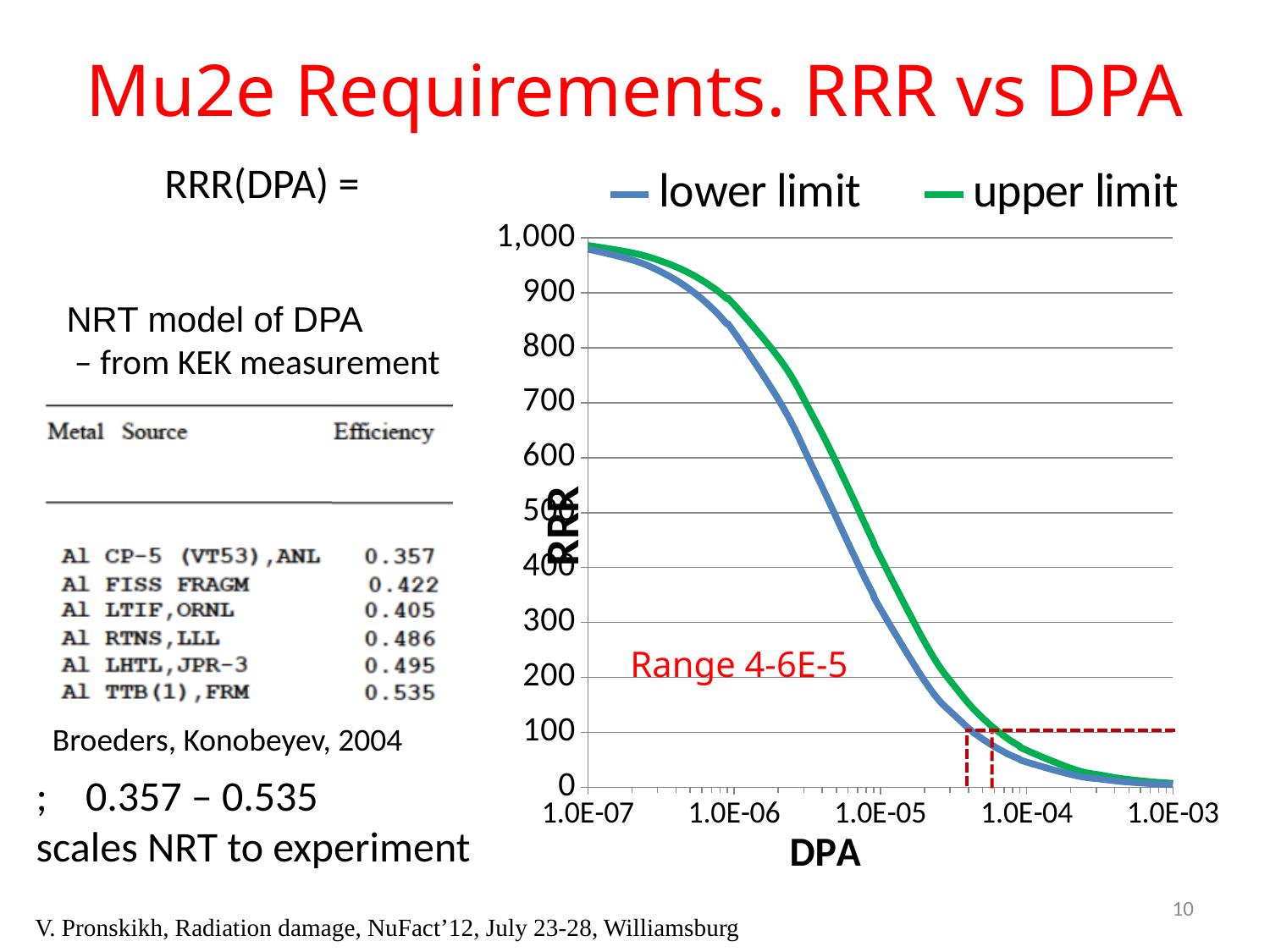
Is the upper limit value at DPA 1.0E-06 greater or less than 800? greater Is the upper limit value at DPA 1.0E-04 greater or less than 100? less What is the label of the x axis of the chart? DPA Is the lower limit value at DPA 1.0E-07 greater or less than 900? greater How many series does the chart legend list? 2 Do the RRR values rise or fall as DPA increases along the x axis? fall At DPA 1.0E-05, which series has the higher RRR value, lower limit or upper limit? upper limit What is the highest tick value shown on the y axis of the chart? 1,000 Which series is drawn in green in the chart? upper limit What kind of chart is shown on the slide? line chart